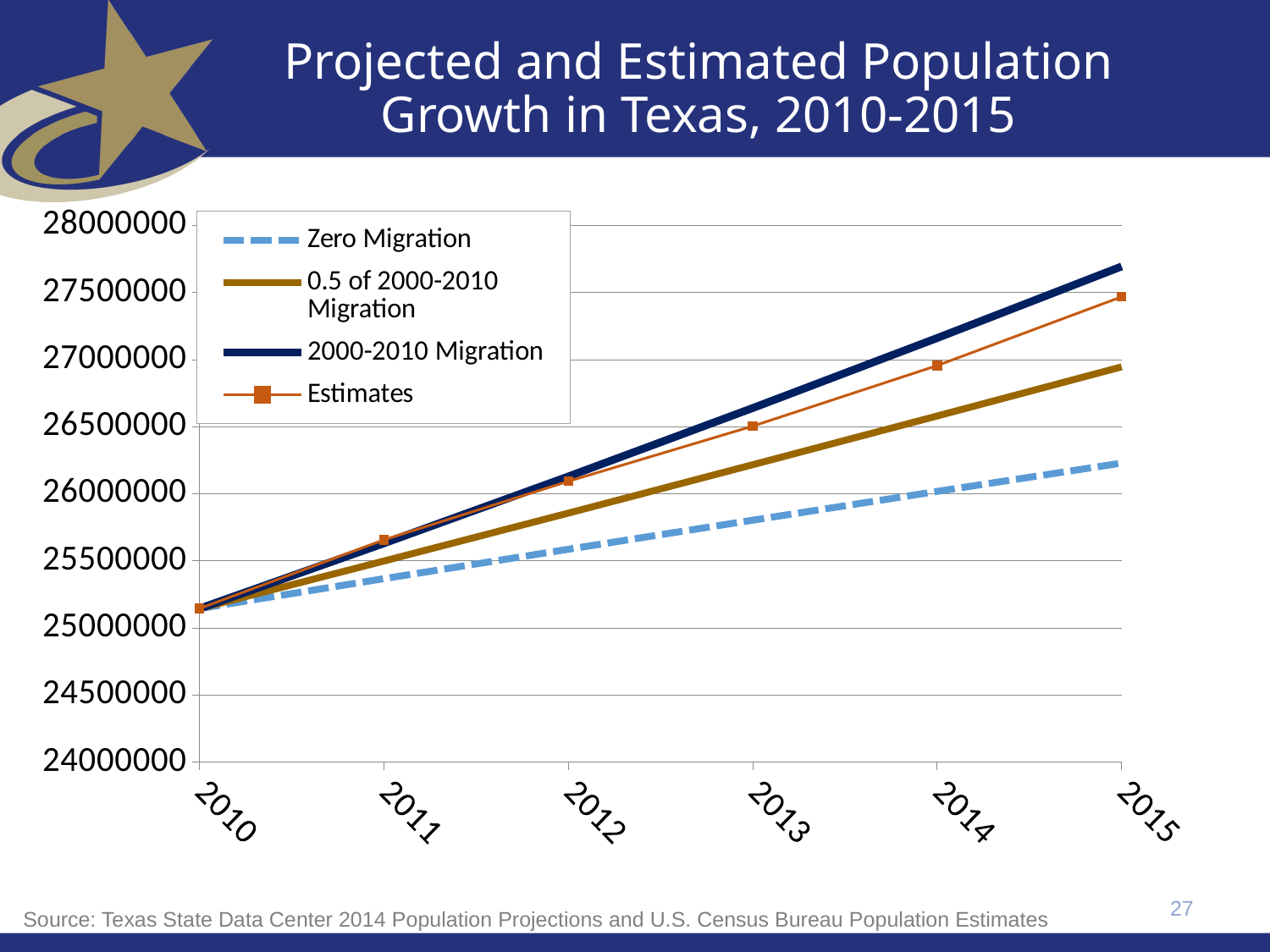
Is the value for Zero Migration in 2015 greater or less than 26000000? greater Do the values for the Estimates series rise or fall from 2010 to 2015? Rise What kind of chart is shown on the slide? Line chart Which series has the lowest value in 2015? Zero Migration In 2015, which is larger: 2000-2010 Migration or Zero Migration? 2000-2010 Migration Is the value for 2000-2010 Migration in 2015 greater or less than 27500000? greater In 2014, which is larger: Estimates or 0.5 of 2000-2010 Migration? Estimates How many series does the legend list? 4 Is the value for Zero Migration in 2013 greater or less than 26000000? less What is the title of the chart? Projected and Estimated Population Growth in Texas, 2010-2015 How many years are shown along the x axis? 6 Which series has the highest value in 2015? 2000-2010 Migration